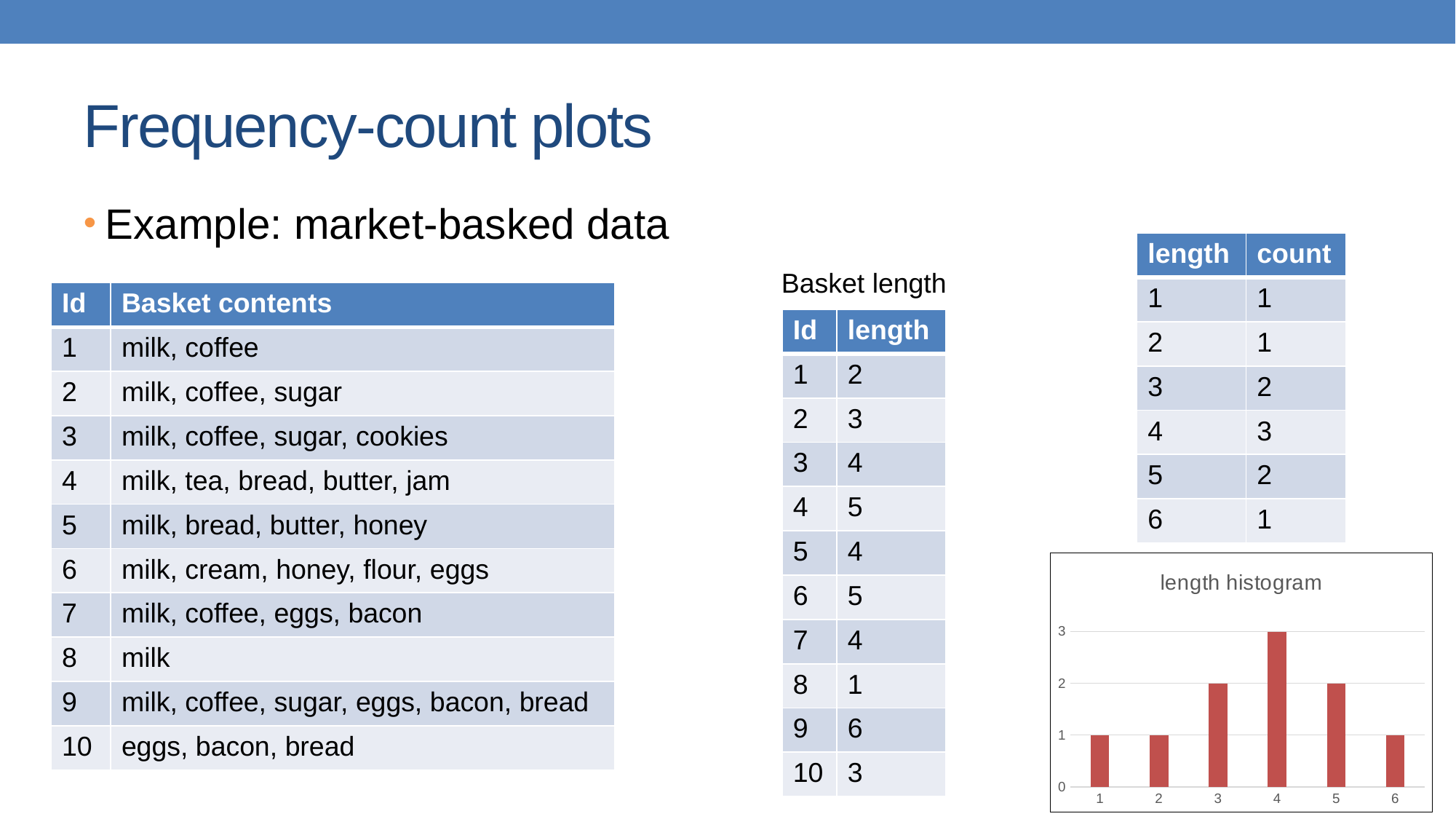
In the length histogram, which is larger, the count for length 5 or the count for length 2? length 5 What is the title of the chart on the slide? length histogram What is the highest value shown on the vertical axis of the length histogram? 3 In the length histogram, what is the difference between the counts for length 4 and length 1? 2 In the length histogram, do the counts rise or fall from length 4 to length 6? fall What kind of chart is the length histogram? bar chart How many bars does the length histogram show? 6 In the length histogram, what is the count for length 4? 3 In the length histogram, is the count for length 4 greater or less than 2? greater In the length histogram, what is the count for length 3? 2 In the length histogram, what is the count for length 6? 1 In the length histogram, which length has the highest count? 4